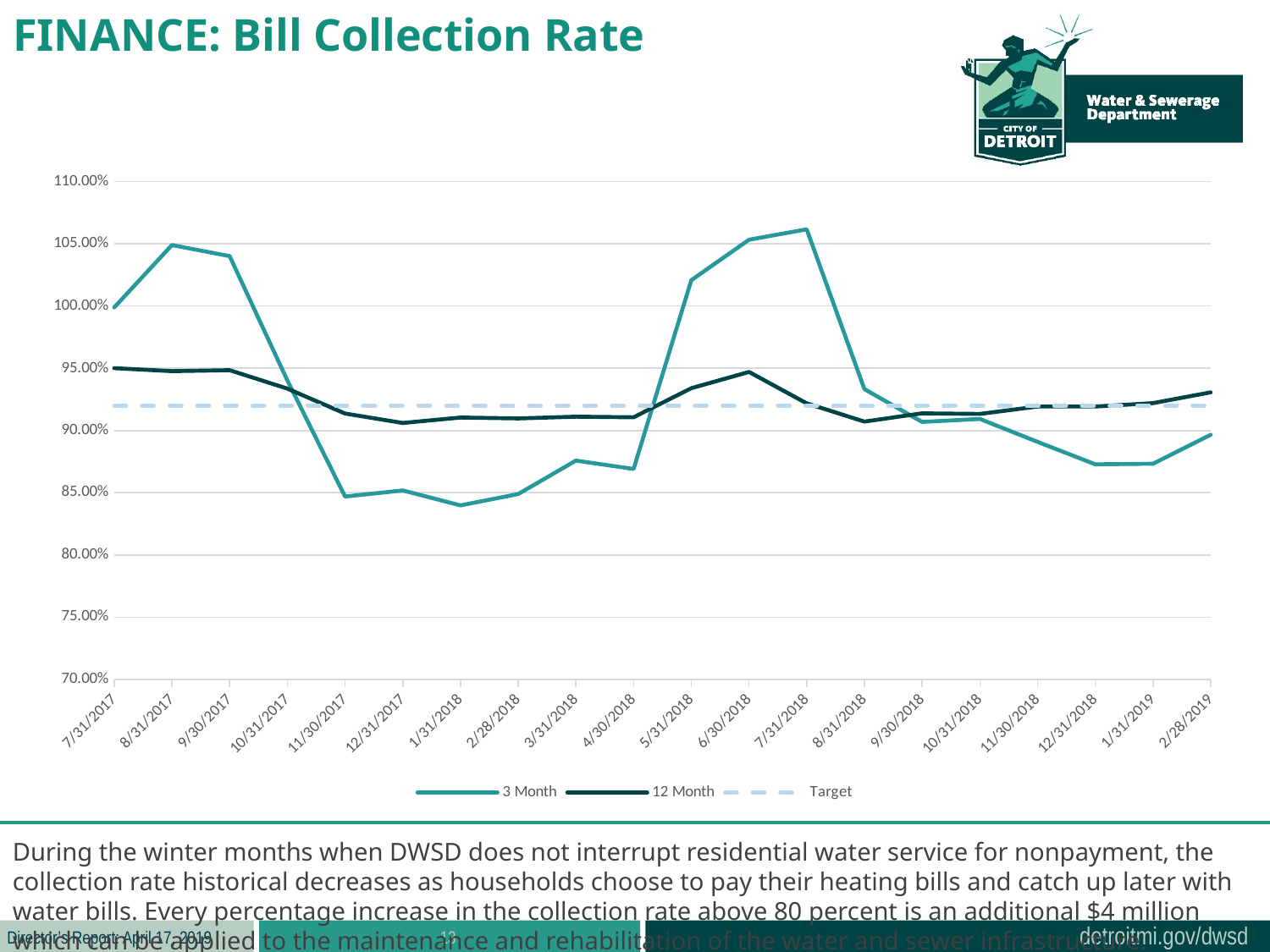
At 7/31/2018, which is larger, the 3 Month value or the 12 Month value? 3 Month Does the 3 Month series rise or fall between 7/31/2018 and 12/31/2018? fall Is the 3 Month value for 11/30/2017 greater or less than 90.00%? less How many dates are shown along the x axis? 20 Is the Target line greater or less than 90.00%? greater What is the title of the slide containing the chart? FINANCE: Bill Collection Rate At which date does the 3 Month series reach its highest value? 7/31/2018 What kind of chart is shown on the slide? line chart Which series are listed in the legend? 3 Month, 12 Month, Target Is the 12 Month value for 12/31/2017 greater or less than 95.00%? less How many series does the legend list? 3